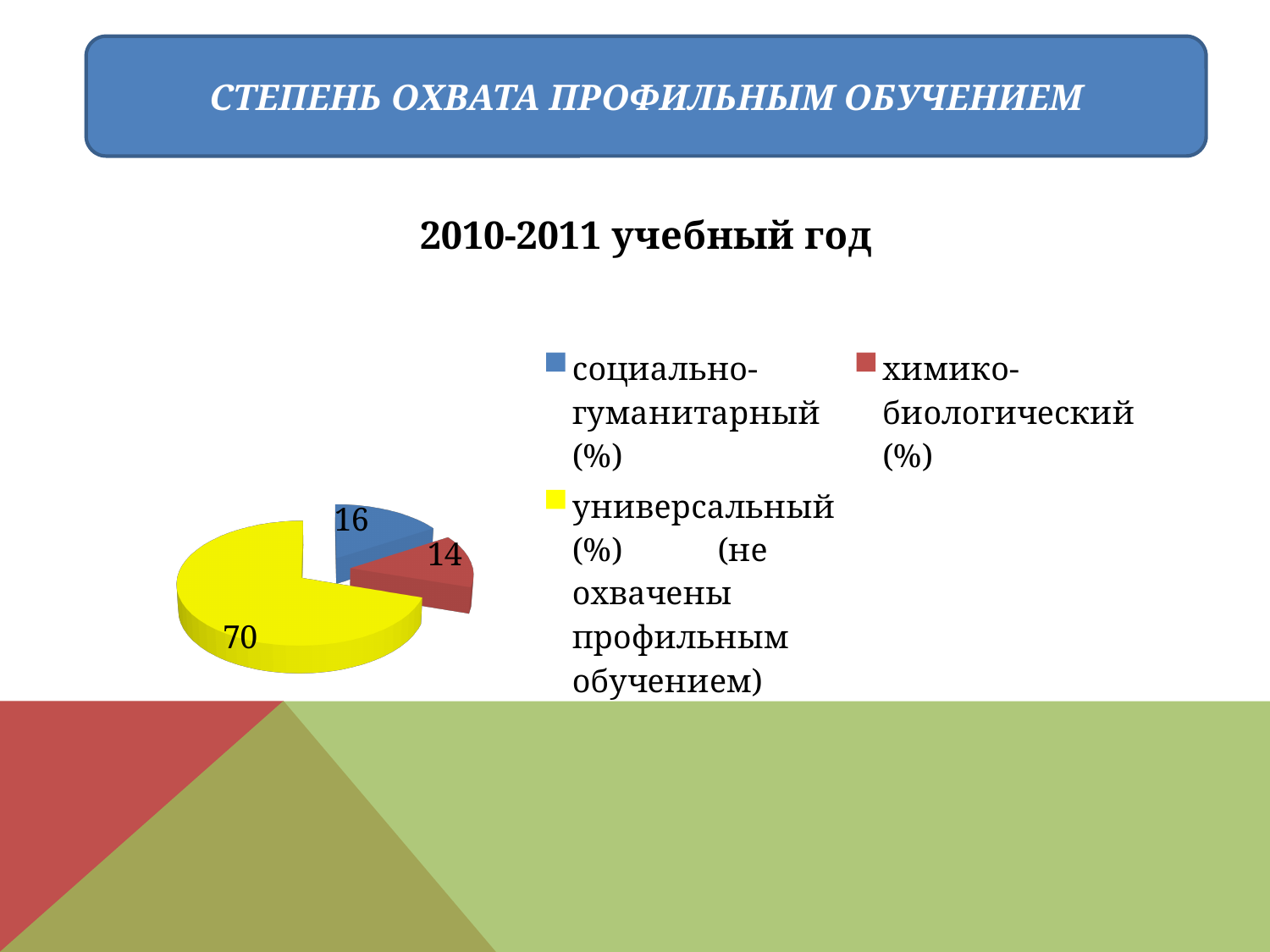
What colour is the slice for универсальный (%)? yellow Which category has the smallest slice of the pie? химико-биологический (%) What is the value for химико-биологический (%)? 14 What is the difference between the values for универсальный and социально-гуманитарный? 54 What is the title of the chart? 2010-2011 учебный год How many slices does the pie chart have? 3 Which category has the largest slice of the pie? универсальный (%) Which is larger, the value for социально-гуманитарный or химико-биологический? социально-гуманитарный What is the value for социально-гуманитарный (%)? 16 What is the value for универсальный (%)? 70 What is the difference between the values for социально-гуманитарный and химико-биологический? 2 What type of chart is shown on the slide? pie chart